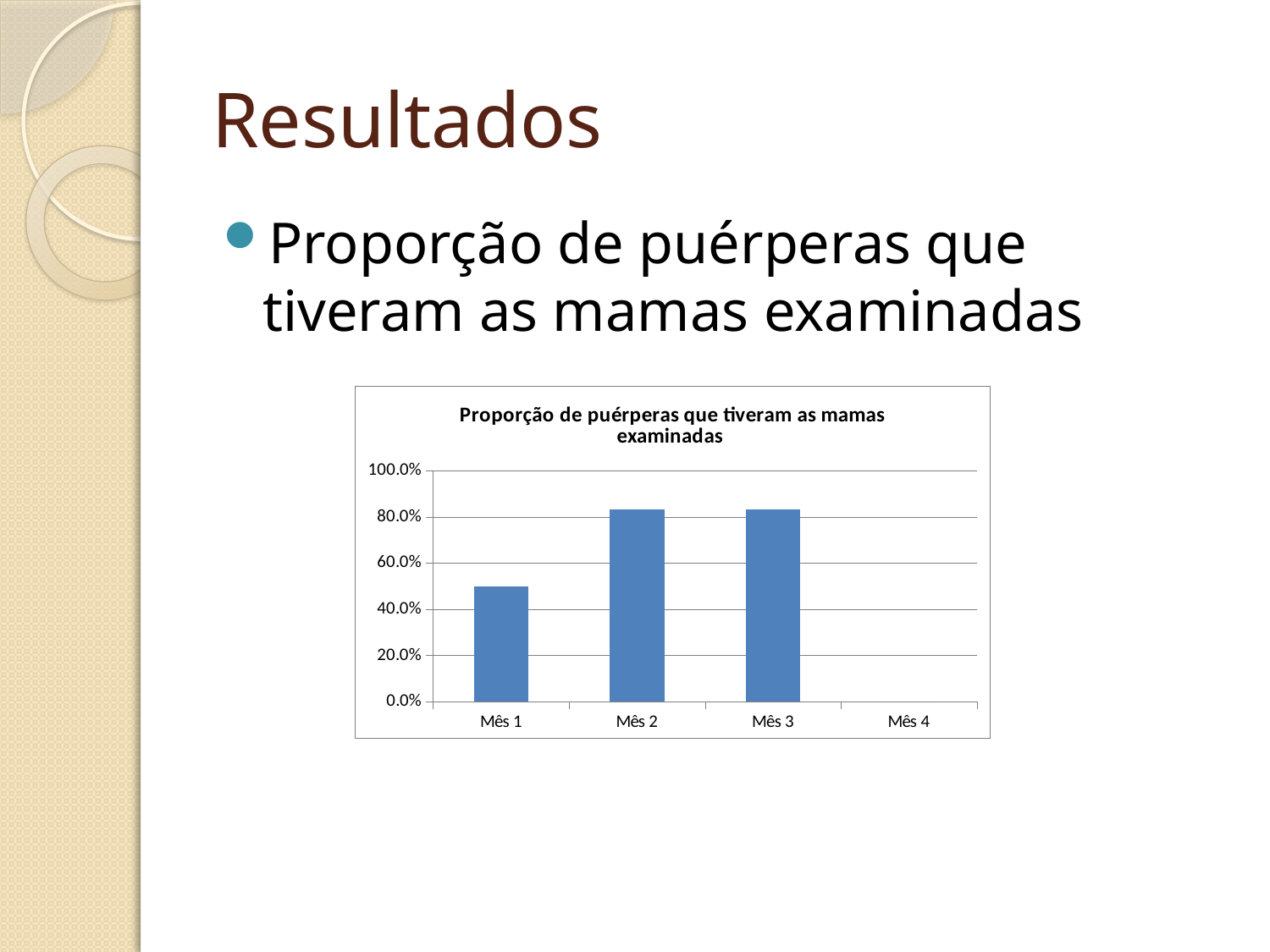
What kind of chart is shown on the slide? bar chart What colour are the bars in the chart? blue Is the value for Mês 2 greater or less than 100.0%? less Is the value for Mês 1 greater or less than 60.0%? less Which is larger, the value for Mês 3 or the value for Mês 1? Mês 3 Is the value for Mês 1 greater or less than 40.0%? greater Which is larger, the value for Mês 1 or the value for Mês 2? Mês 2 Does the value rise or fall from Mês 1 to Mês 2? rise What is the title of the chart? Proporção de puérperas que tiveram as mamas examinadas How many categories are shown on the x axis of the chart? 4